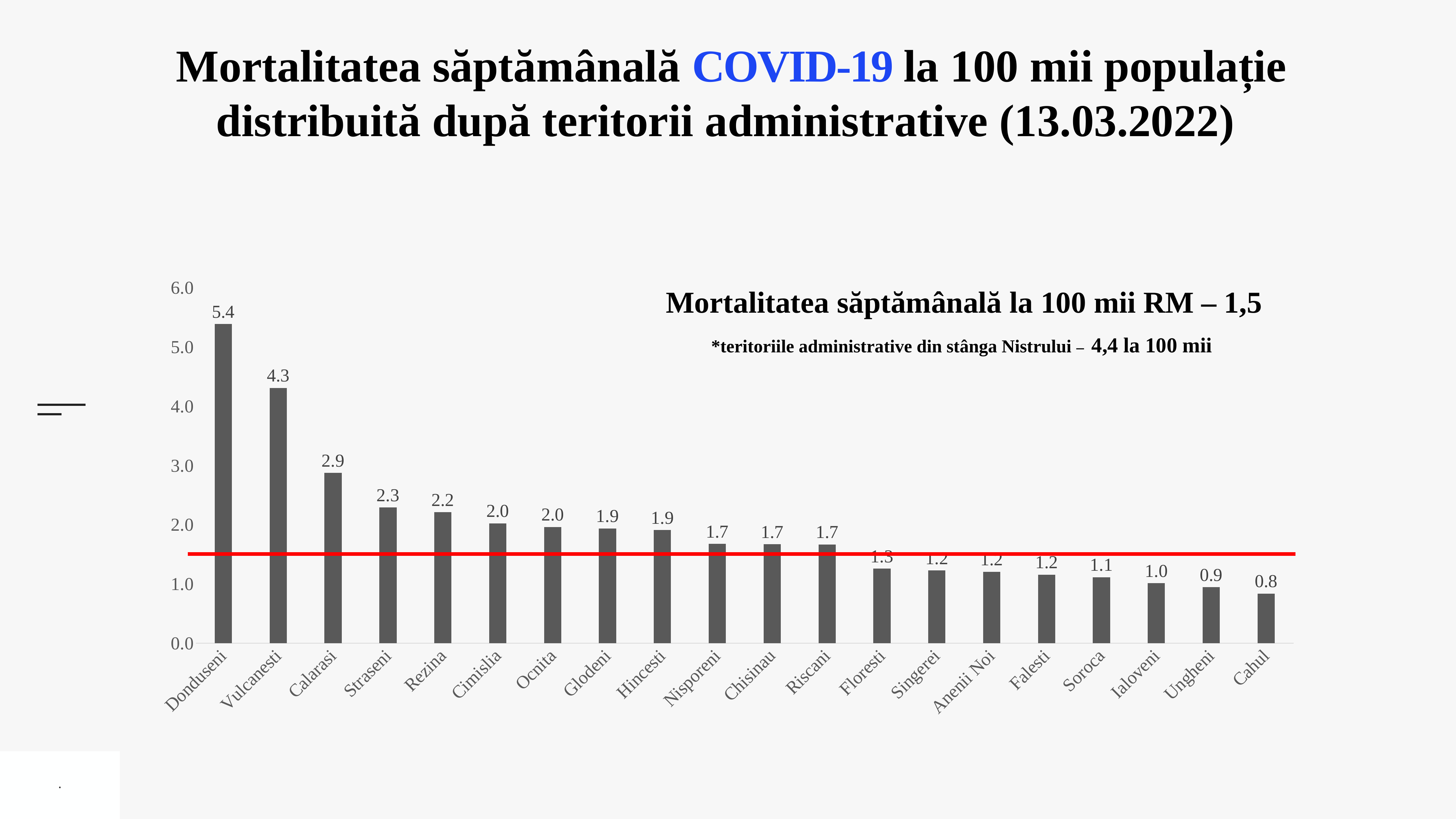
Do the values rise or fall from left to right along the x axis? fall Is the value for Soroca greater or less than 2.0? less What is the value shown for Calarasi? 2.9 What is the value shown for Ungheni? 0.9 What is the difference between the values for Donduseni and Vulcanesti? 1.1 What kind of chart is shown on the slide? bar chart What is the weekly mortality value for Donduseni? 5.4 How many administrative territories are shown in the chart? 20 Which territory has the lowest weekly mortality in the chart? Cahul Which has a higher value, Straseni or Rezina? Straseni Which territory has the highest weekly mortality in the chart? Donduseni What national (RM) weekly mortality value per 100 thousand does the slide state, marked by the red line? 1,5